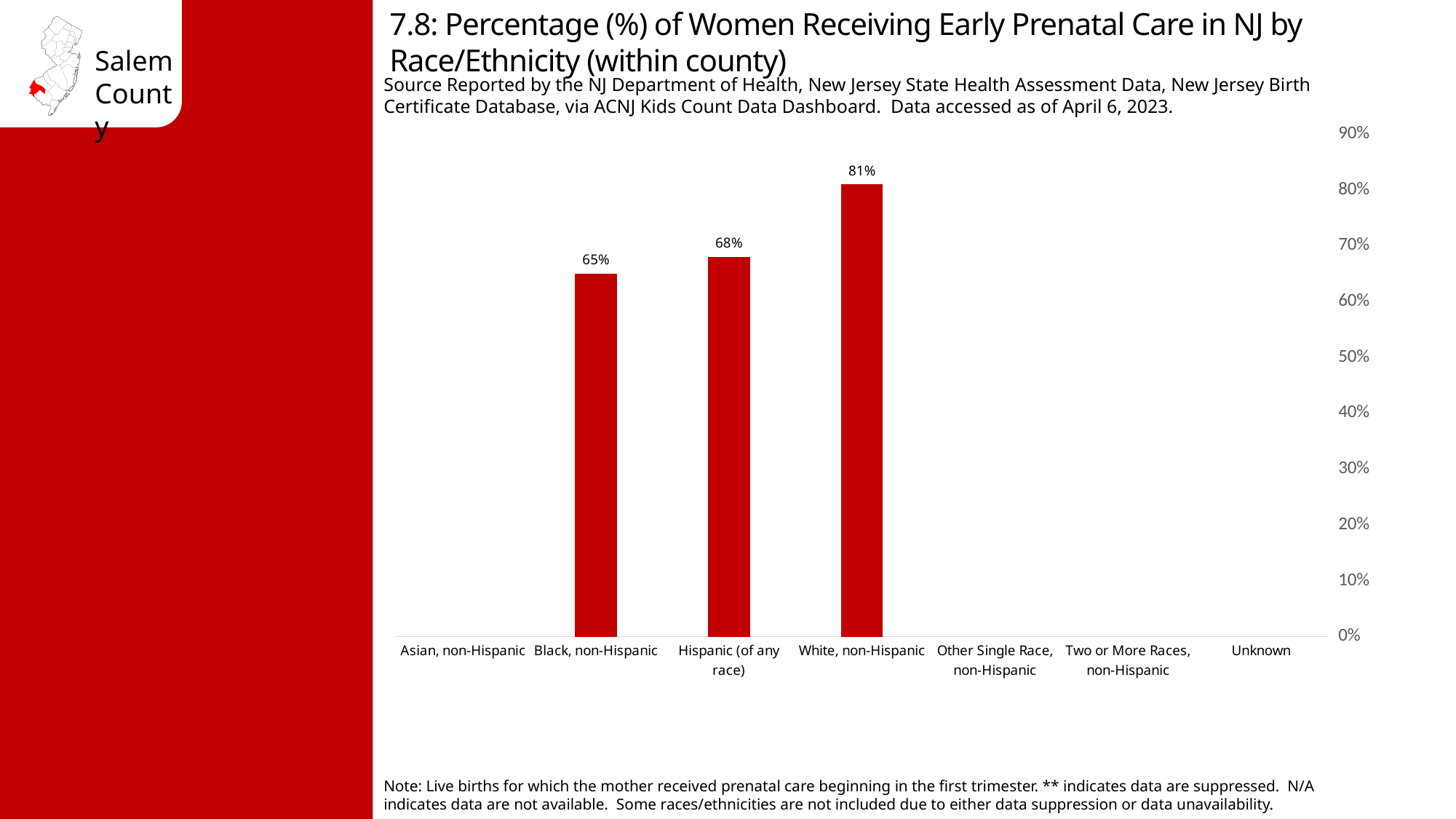
What percentage is shown for White, non-Hispanic women? 81% What percentage of Black, non-Hispanic women received early prenatal care? 65% How many race/ethnicity categories are labeled on the x axis? 7 What is the difference between the Hispanic (of any race) and Black, non-Hispanic values? 3% What is the difference between the White, non-Hispanic and Black, non-Hispanic percentages? 16% What kind of chart is shown on the slide? Bar chart Which is larger, the value for Hispanic (of any race) or for Black, non-Hispanic? Hispanic (of any race) What is the value shown for Hispanic (of any race)? 68% Among the categories with a plotted bar, which has the lowest percentage? Black, non-Hispanic Which race/ethnicity category has the highest percentage of women receiving early prenatal care? White, non-Hispanic What is the highest value shown on the y axis? 90% Is the value for White, non-Hispanic greater or less than 70%? greater